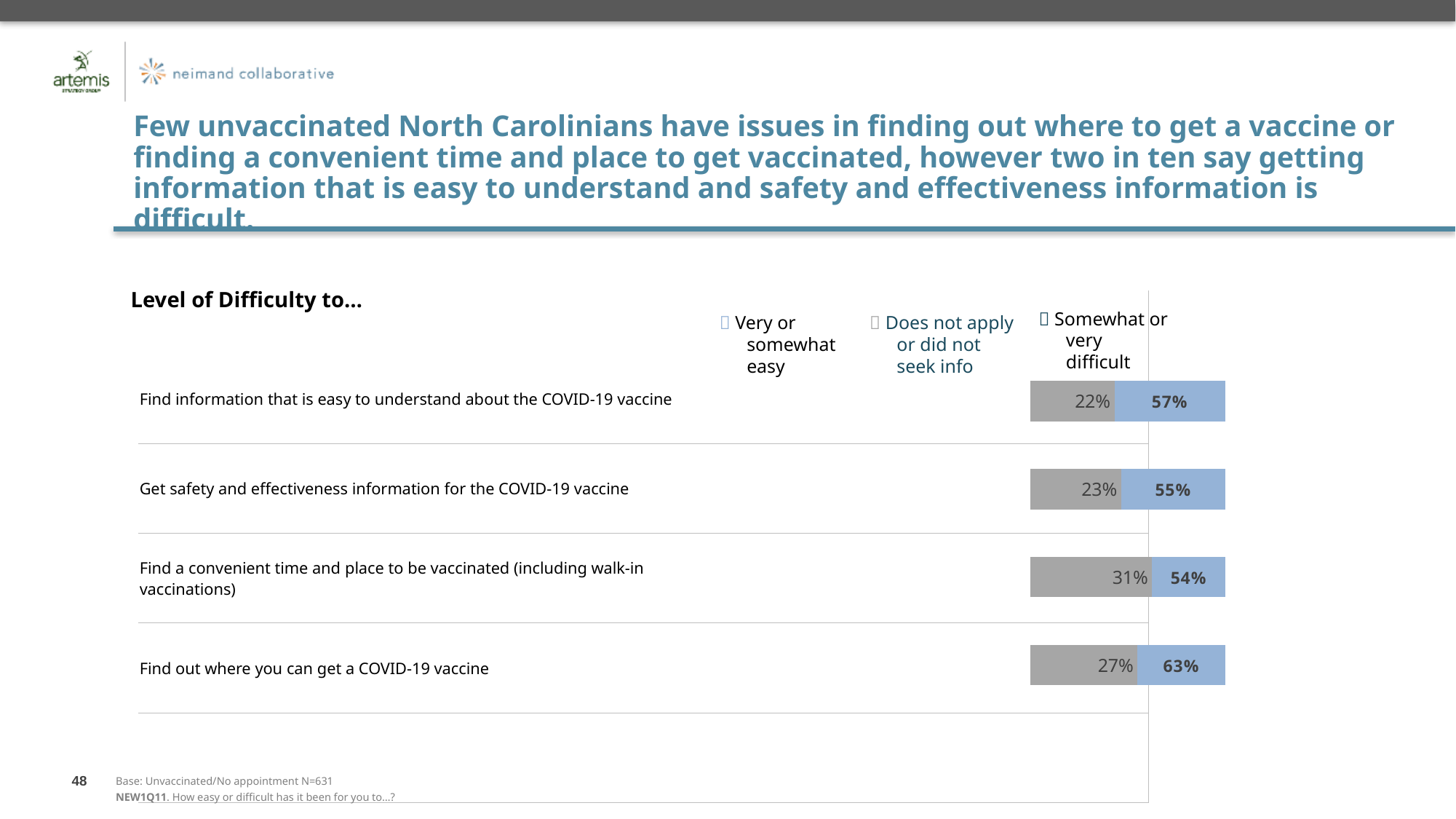
What is the value of the blue segment for "Find out where you can get a COVID-19 vaccine"? 63% What kind of chart is shown on the slide? bar chart What is the title of the chart? Level of Difficulty to… How many series does the chart legend list? 3 Which has the larger gray segment value: "Get safety and effectiveness information for the COVID-19 vaccine" or "Find out where you can get a COVID-19 vaccine"? Find out where you can get a COVID-19 vaccine What is the value of the gray segment for "Find a convenient time and place to be vaccinated (including walk-in vaccinations)"? 31% What is the value of the blue segment for "Get safety and effectiveness information for the COVID-19 vaccine"? 55% Which category has the lowest gray segment value? Find information that is easy to understand about the COVID-19 vaccine What is the difference between the blue segment values for "Find out where you can get a COVID-19 vaccine" and "Find a convenient time and place to be vaccinated"? 9 percentage points How many categories (rows) are plotted in the chart? 4 What are the three entries in the chart legend? Very or somewhat easy; Does not apply or did not seek info; Somewhat or very difficult Which category has the highest blue segment value? Find out where you can get a COVID-19 vaccine